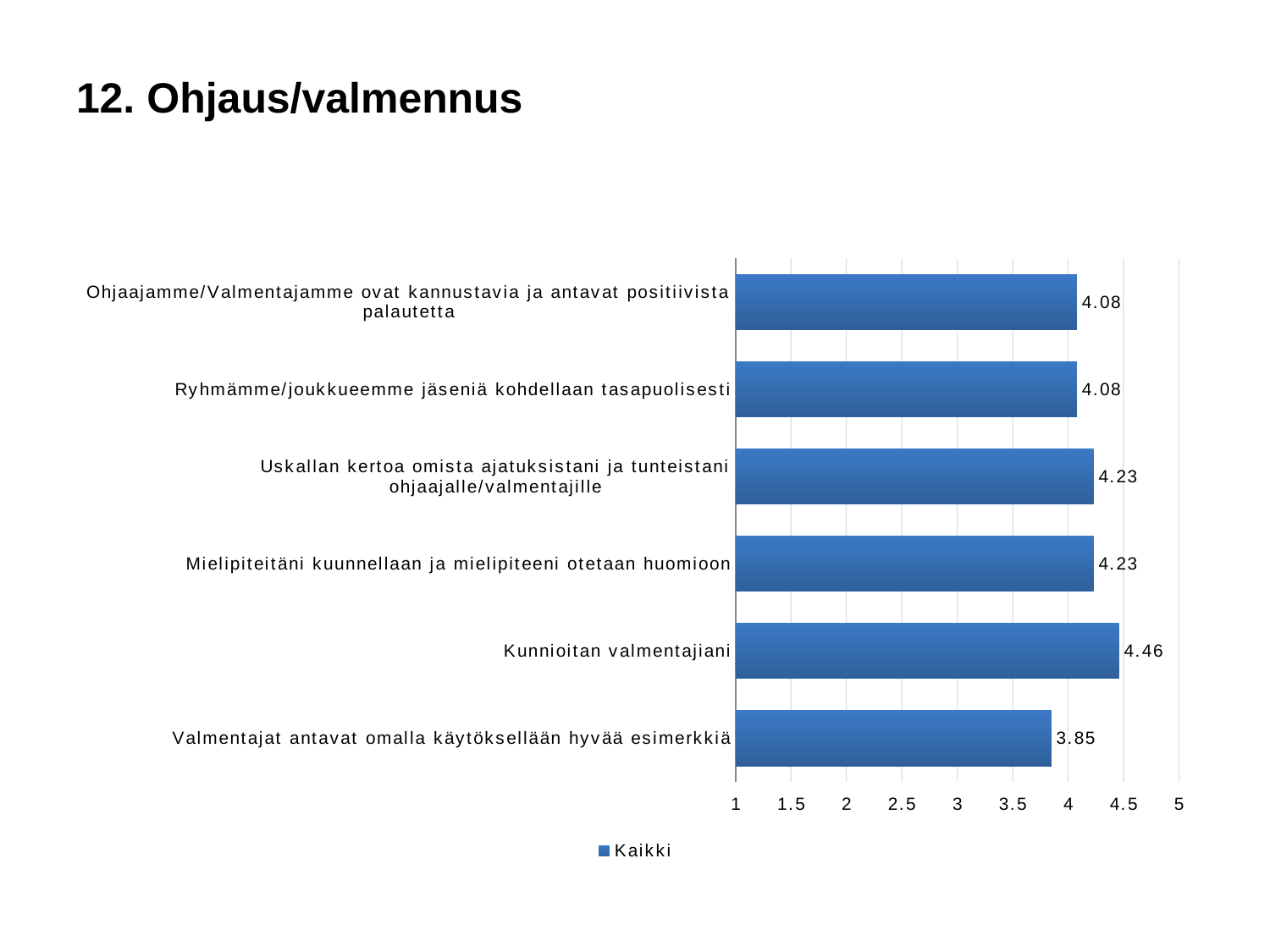
What is the value for "Kunnioitan valmentajiani"? 4.46 Is the value for "Valmentajat antavat omalla käytöksellään hyvää esimerkkiä" greater or less than 4? less What is the value for "Valmentajat antavat omalla käytöksellään hyvää esimerkkiä"? 3.85 How many categories are shown in the chart? 6 Which category has the lowest value? Valmentajat antavat omalla käytöksellään hyvää esimerkkiä What is the value for "Ryhmämme/joukkueemme jäseniä kohdellaan tasapuolisesti"? 4.08 Which is larger: the value for "Uskallan kertoa omista ajatuksistani ja tunteistani ohjaajalle/valmentajille" or the value for "Ohjaajamme/Valmentajamme ovat kannustavia ja antavat positiivista palautetta"? Uskallan kertoa omista ajatuksistani ja tunteistani ohjaajalle/valmentajille What kind of chart is shown on the slide? Bar chart Which category has the highest value? Kunnioitan valmentajiani What is the difference between the values for "Kunnioitan valmentajiani" and "Valmentajat antavat omalla käytöksellään hyvää esimerkkiä"? 0.61 How many series does the legend list? 1 What is the value for "Mielipiteitäni kuunnellaan ja mielipiteeni otetaan huomioon"? 4.23